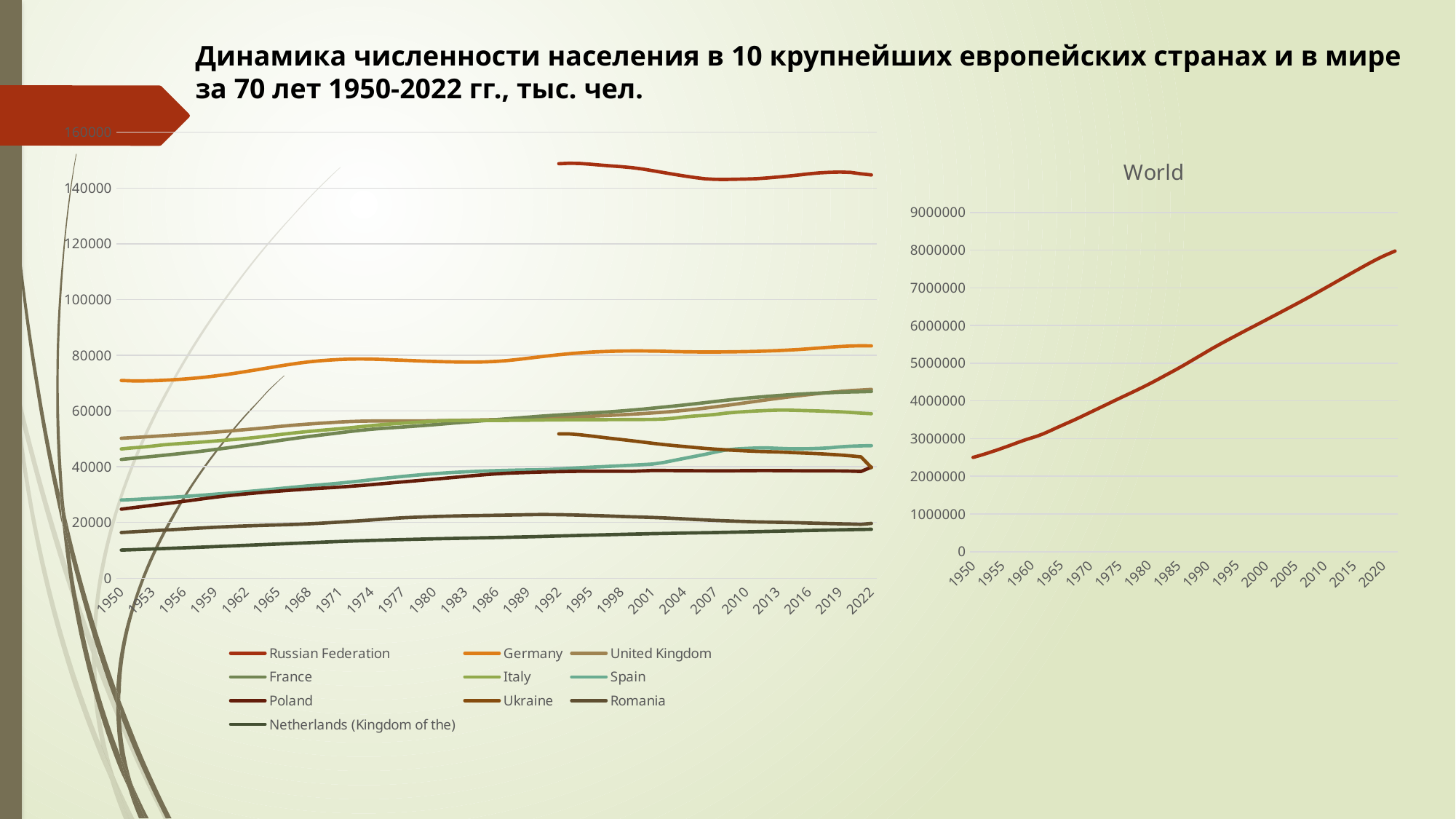
In the left chart (European countries), which country has the highest population line? Russian Federation In the left chart (European countries), is the value for Ukraine in 1992 greater or less than 40000? greater In the left chart (European countries), which is larger in 2022: Germany or France? Germany In the left chart (European countries), is the value for the Russian Federation in 2022 greater or less than 140000? greater How many series does the legend of the left chart (European countries) list? 10 In the chart titled "World", do the values rise or fall from 1950 to 2020? rise In the left chart (European countries), is the value for Germany in 1950 greater or less than 80000? less In the left chart (European countries), which country has the lowest population line in 1950? Netherlands (Kingdom of the) What kind of chart is the chart titled "World" on the right of the slide? line chart In the left chart (European countries), which is larger in 2022: Spain or Poland? Spain